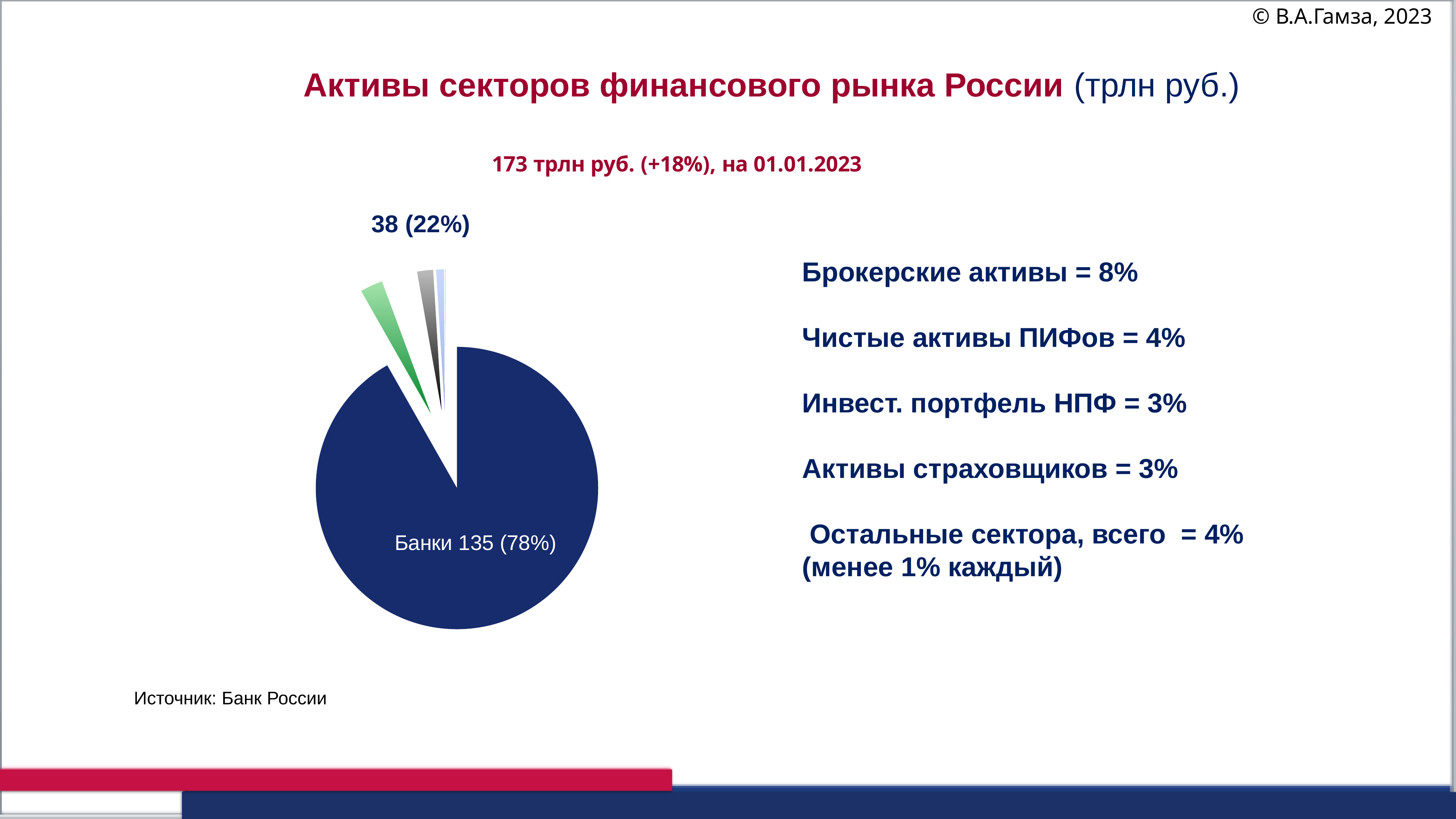
Which slice of the pie chart is the largest? Банки Which is larger: the assets of Банки or the combined assets of all other sectors? Банки What value is printed for the Банки slice of the pie chart? 135 (78%) What value is printed for the non-bank slices of the pie chart combined? 38 (22%) What share of the pie do Банки account for? 78% What is the title of the chart on the slide? 173 трлн руб. (+18%), на 01.01.2023 What is the difference between the assets of Банки (135) and the other sectors (38)? 97 What source is cited for the chart data? Банк России What share of assets do Брокерские активы account for, according to the slide? 8% What is the total of all financial market sector assets shown on the slide? 173 трлн руб. What share of assets do Чистые активы ПИФов account for, according to the slide? 4% What kind of chart is shown on the slide? pie chart